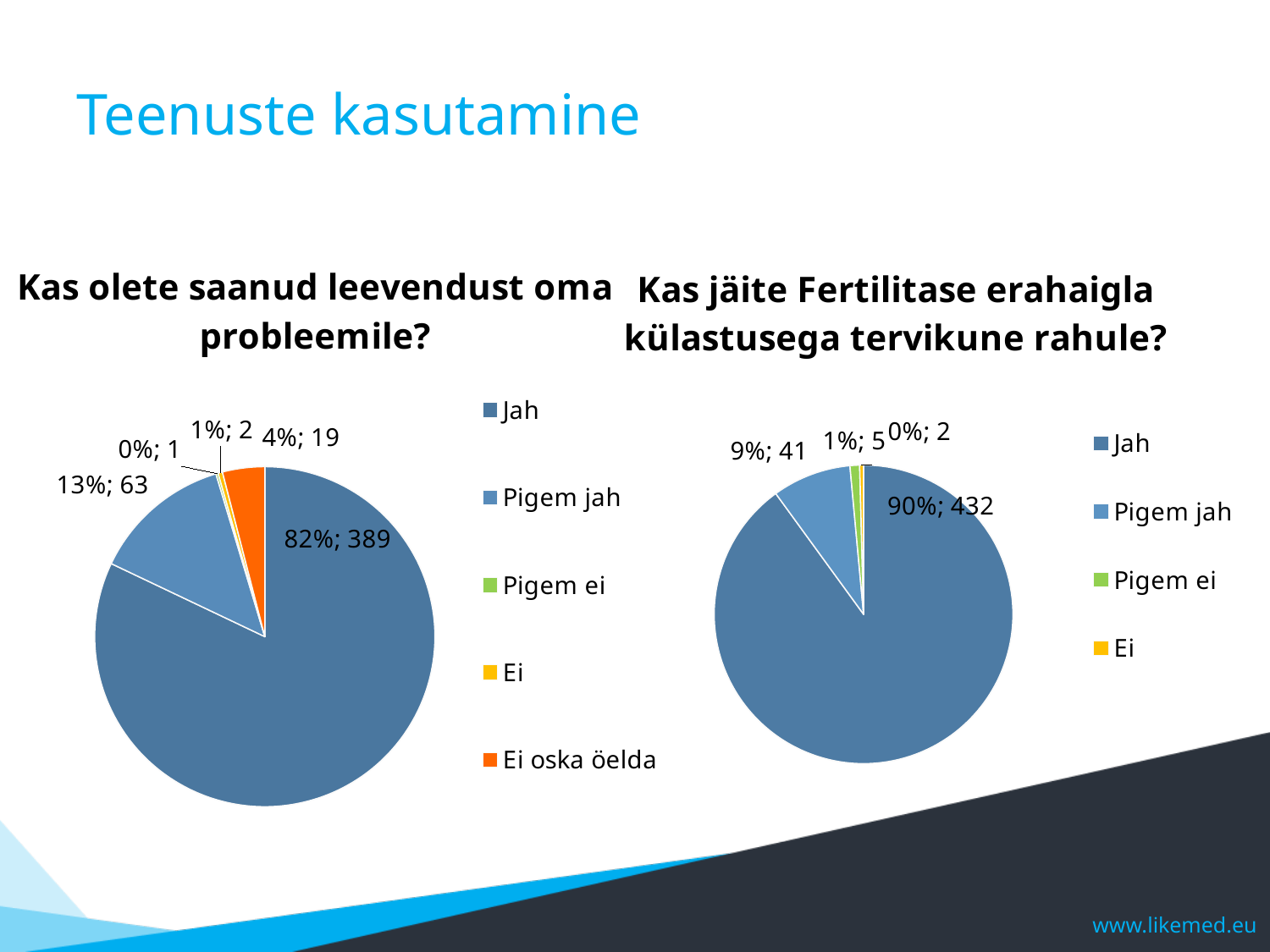
In the left pie chart (Kas olete saanud leevendust oma probleemile?), what is the data label for the Pigem jah slice? 13%; 63 In the right pie chart (Kas jäite Fertilitase erahaigla külastusega tervikune rahule?), what is the data label for the Pigem jah slice? 9%; 41 In the right pie chart (Kas jäite Fertilitase erahaigla külastusega tervikune rahule?), which category has the smallest slice? Ei In the left pie chart (Kas olete saanud leevendust oma probleemile?), what share of the pie does the Jah slice take? 82% In the left pie chart (Kas olete saanud leevendust oma probleemile?), what is the data label for the Jah slice? 82%; 389 In the right pie chart (Kas jäite Fertilitase erahaigla külastusega tervikune rahule?), how many categories does the legend list? 4 What kind of chart is used on the right side of the slide (Kas jäite Fertilitase erahaigla külastusega tervikune rahule?)? Pie chart Which is larger: the count for Pigem jah in the left pie chart (63) or the count for Pigem jah in the right pie chart (41)? Left pie chart (63) In the left pie chart (Kas olete saanud leevendust oma probleemile?), which category has the largest slice? Jah In the right pie chart (Kas jäite Fertilitase erahaigla külastusega tervikune rahule?), what is the data label for the Jah slice? 90%; 432 In the left pie chart (Kas olete saanud leevendust oma probleemile?), what is the data label for the Ei oska öelda slice? 4%; 19 In the left pie chart (Kas olete saanud leevendust oma probleemile?), how many categories does the legend list? 5